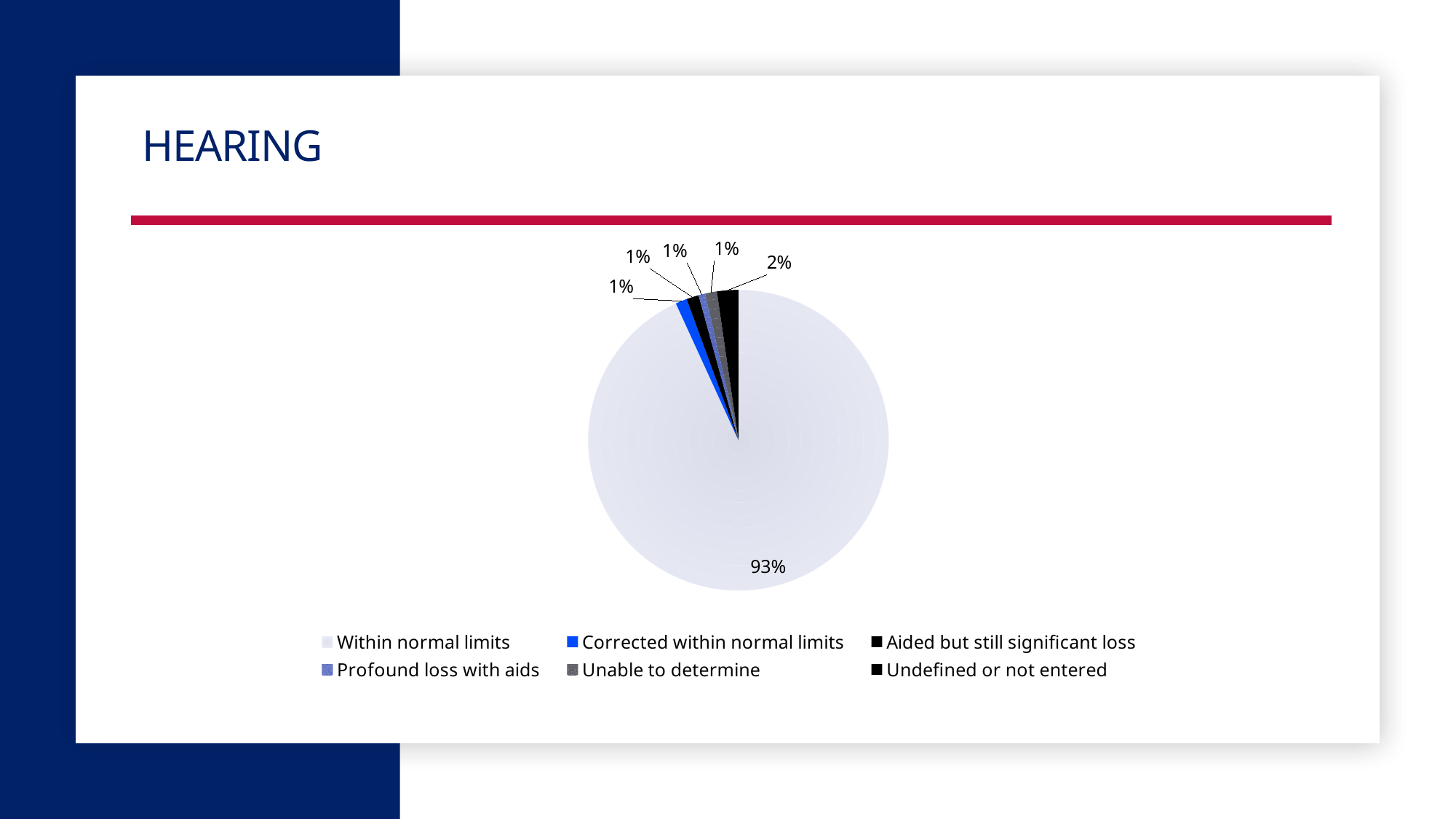
Which category has the largest share of the pie? Within normal limits What share of the pie does the 'Within normal limits' slice represent? 93% What percentage of the pie is 'Within normal limits'? 93% Which legend entry is shown in bright blue? Corrected within normal limits What percentage of the pie is 'Undefined or not entered'? 2% What is the title of the slide containing the chart? HEARING Which is larger, the share for 'Within normal limits' or the share for 'Undefined or not entered'? Within normal limits How many entries does the legend list? 6 What is the difference in percentage points between 'Within normal limits' and 'Undefined or not entered'? 91 percentage points How many categories does the pie chart have? 6 What type of chart is shown on the slide? Pie chart